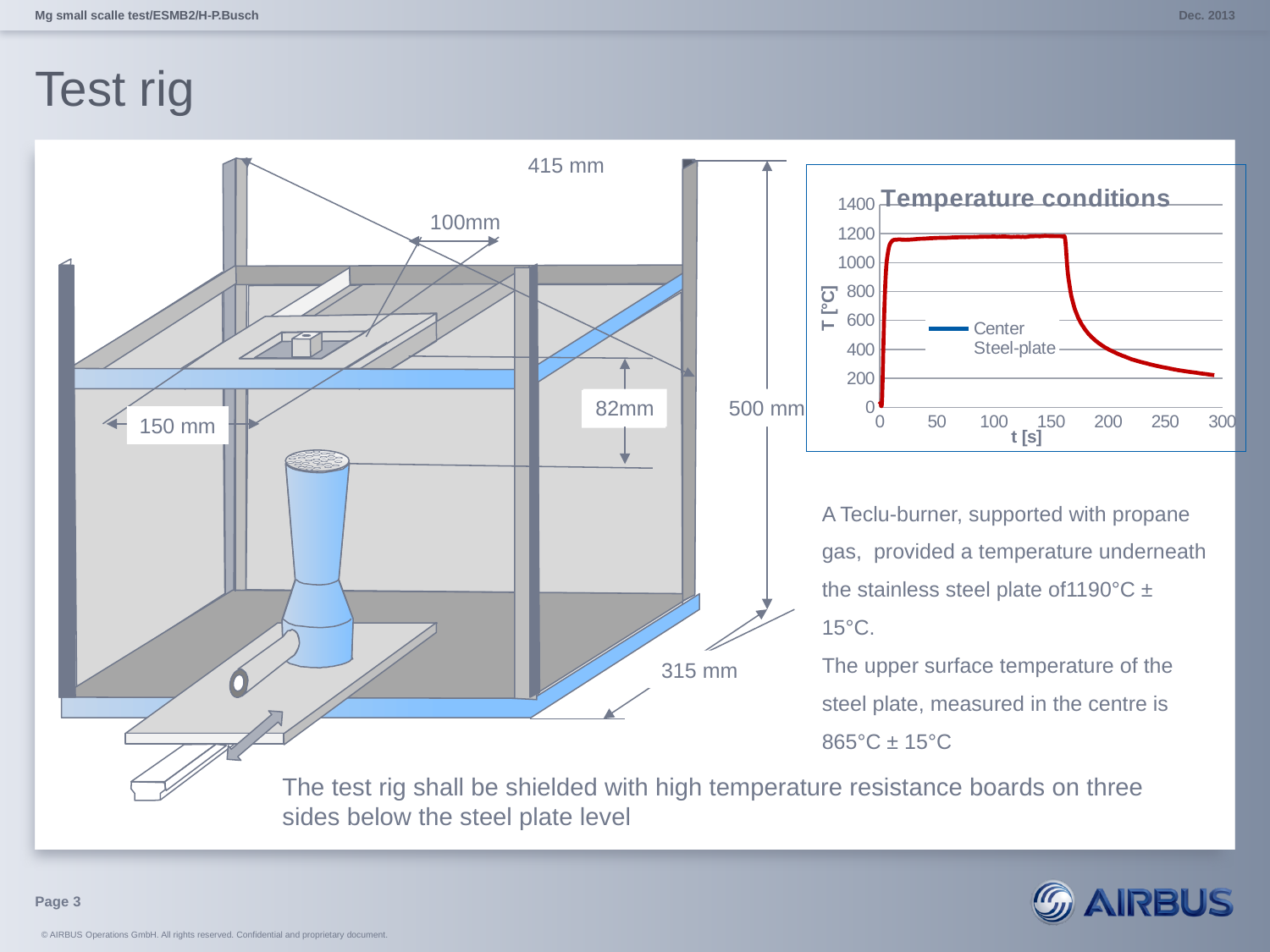
How many series does the chart's legend list? 1 Is the temperature of the Center Steel-plate at t = 100 s greater or less than 1000? greater What is the label of the x axis of the chart? t [s] What is the label of the y axis of the chart? T [°C] What kind of chart is shown on the slide? line chart What is the highest tick value shown on the y axis of the chart? 1400 Is the temperature of the Center Steel-plate at t = 50 s greater or less than 800? greater Is the temperature of the Center Steel-plate at t = 250 s greater or less than 600? less What is the highest tick value shown on the x axis of the chart? 300 Does the temperature rise or fall between t = 200 s and t = 300 s? fall What is the name of the series shown in the chart's legend? Center Steel-plate What is the title of the chart on the slide? Temperature conditions